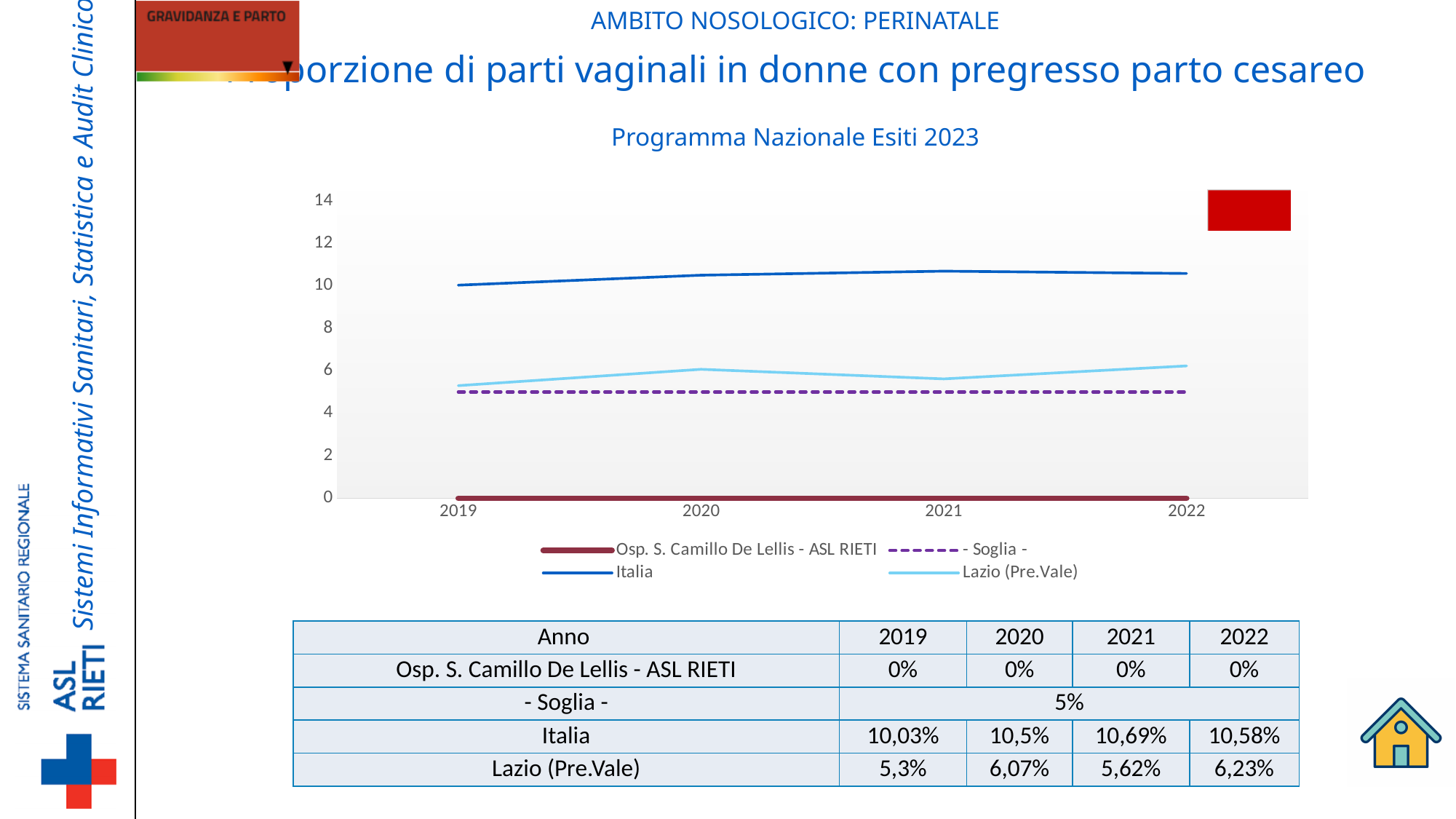
How many series does the chart legend list? 4 What is the difference between Italia and Lazio (Pre.Vale) in 2019? 4,73% Is the value for Italia in 2022 greater or less than 10? greater In which year is the Italia series highest? 2021 What is the value for Osp. S. Camillo De Lellis - ASL RIETI in 2020? 0% In which year is the Lazio (Pre.Vale) series lowest? 2019 Which is larger in 2020, Italia or Lazio (Pre.Vale)? Italia What is the value for Lazio (Pre.Vale) in 2022? 6,23% How many years are shown on the x axis of the chart? 4 What is the value of the Soglia (threshold) line? 5% What kind of chart is shown on the slide? line chart What is the value for Italia in 2021? 10,69%